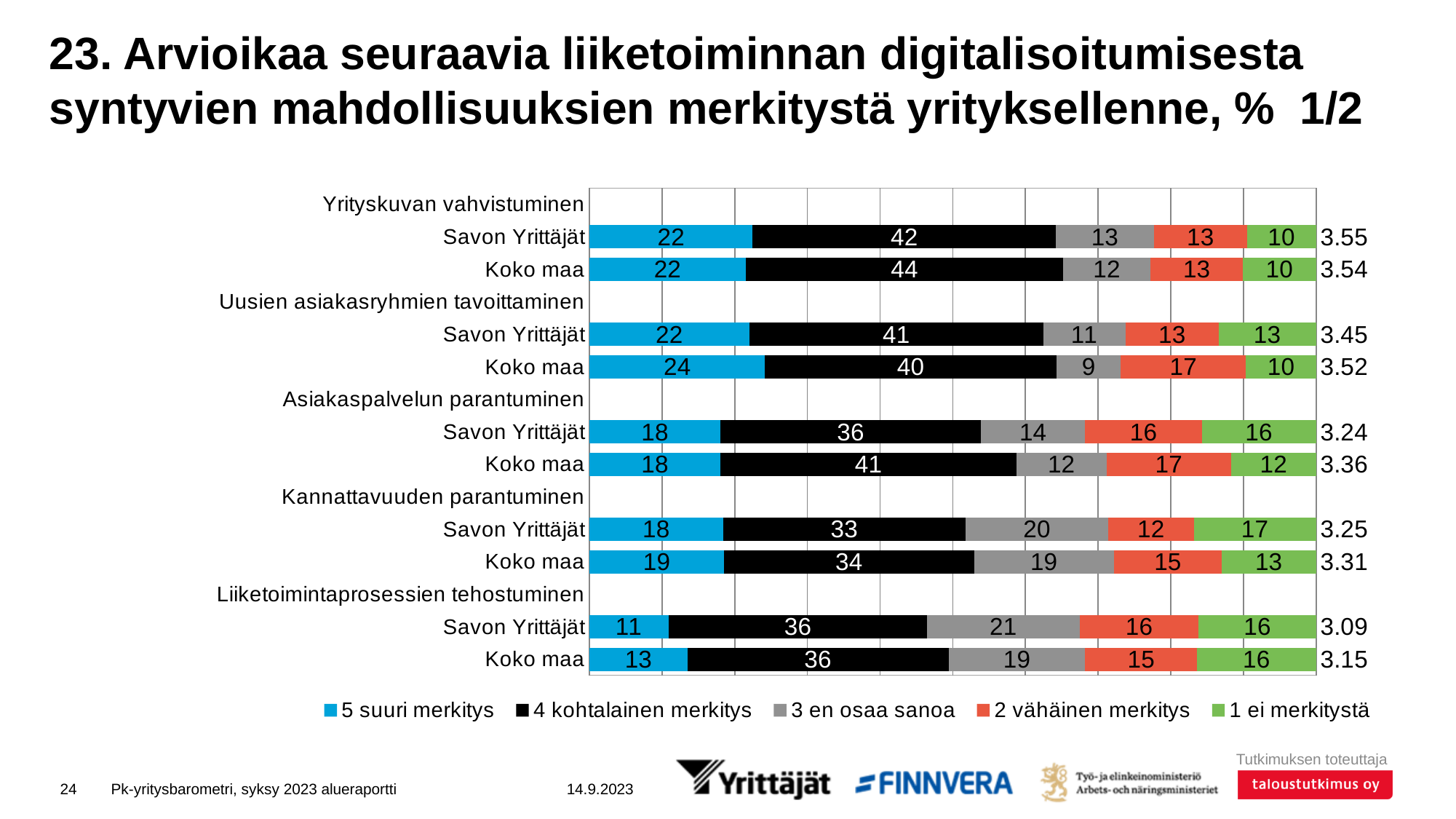
Under Kannattavuuden parantuminen, which has the larger "1 ei merkitystä" value, Savon Yrittäjät or Koko maa? Savon Yrittäjät How many series does the legend list? 5 Among the Savon Yrittäjät bars, which topic has the lowest value for "5 suuri merkitys"? Liiketoimintaprosessien tehostuminen Under Uusien asiakasryhmien tavoittaminen, what is the difference between the "2 vähäinen merkitys" values for Koko maa and Savon Yrittäjät? 4 What is the value of "3 en osaa sanoa" for Savon Yrittäjät under Liiketoimintaprosessien tehostuminen? 21 What is the mean score shown at the right of the Savon Yrittäjät bar under Yrityskuvan vahvistuminen? 3.55 What is the value of "5 suuri merkitys" for Savon Yrittäjät under Yrityskuvan vahvistuminen? 22 What is the total of the Savon Yrittäjät stacked bar under Yrityskuvan vahvistuminen? 100 What is the value of "4 kohtalainen merkitys" for Koko maa under Asiakaspalvelun parantuminen? 41 What is the value of "2 vähäinen merkitys" for Koko maa under Kannattavuuden parantuminen? 15 How many topic groups (each with a Savon Yrittäjät and a Koko maa bar) are shown in the chart? 5 What kind of chart is shown on the slide? Stacked bar chart